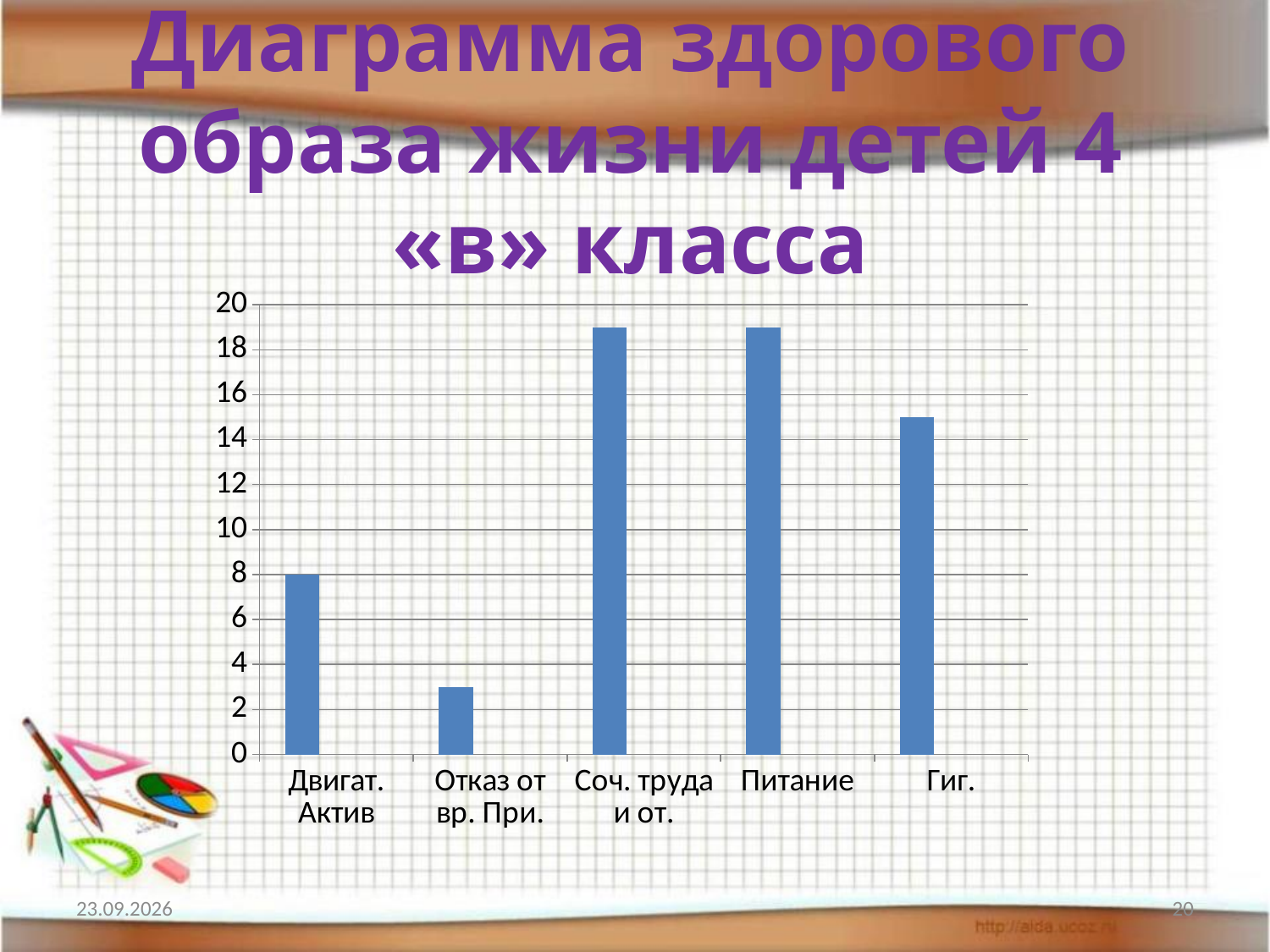
Which category has the lowest value? Отказ от вр. При. Which is larger, the value for Питание or the value for Гиг.? Питание What is the value for Двигат. Актив? 8 Is the value for Питание greater or less than 18? greater What kind of chart is shown on the slide? bar chart Which is larger, the value for Двигат. Актив or the value for Отказ от вр. При.? Двигат. Актив Is the value for Отказ от вр. При. greater or less than 4? less What is the title of the slide containing the chart? Диаграмма здорового образа жизни детей 4 «в» класса Is the value for Гиг. greater or less than 14? greater How many categories are shown on the x axis of the chart? 5 Which is larger, the value for Гиг. or the value for Двигат. Актив? Гиг.